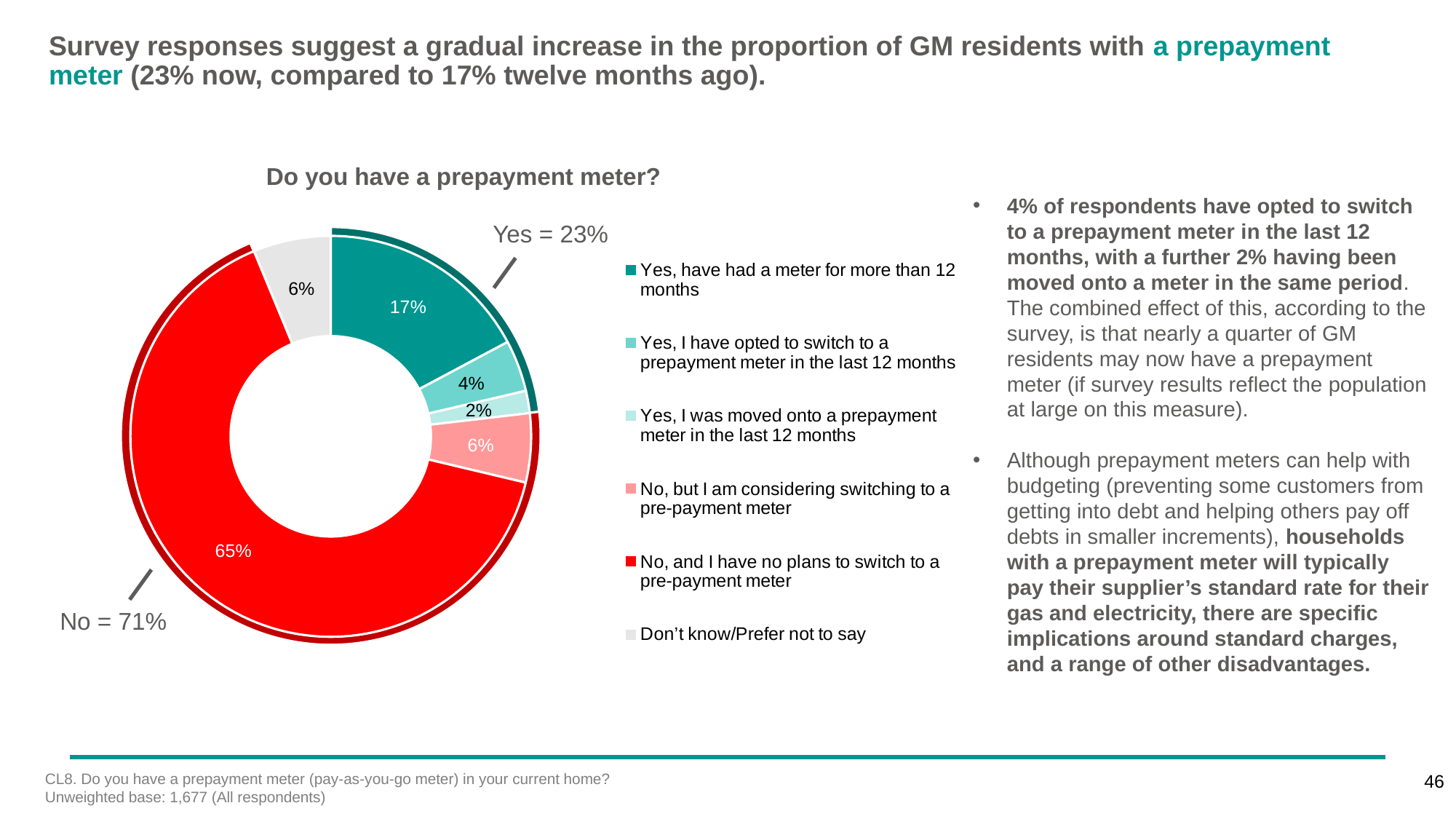
What percentage of respondents said 'No, and I have no plans to switch to a pre-payment meter'? 65% Which category has the smallest share of the chart? Yes, I was moved onto a prepayment meter in the last 12 months Which category has the largest share of the chart? No, and I have no plans to switch to a pre-payment meter What is the title of the chart? Do you have a prepayment meter? What kind of chart is shown on the slide? Pie chart (doughnut) How many categories does the legend list? 6 What percentage of respondents were moved onto a prepayment meter in the last 12 months? 2% What percentage of respondents answered 'Don't know/Prefer not to say'? 6% What percentage of respondents have had a meter for more than 12 months? 17% What is the combined 'Yes' total shown on the chart? 23% What percentage of respondents opted to switch to a prepayment meter in the last 12 months? 4% What is the difference between the share who have had a meter for more than 12 months and the share who opted to switch in the last 12 months? 13%